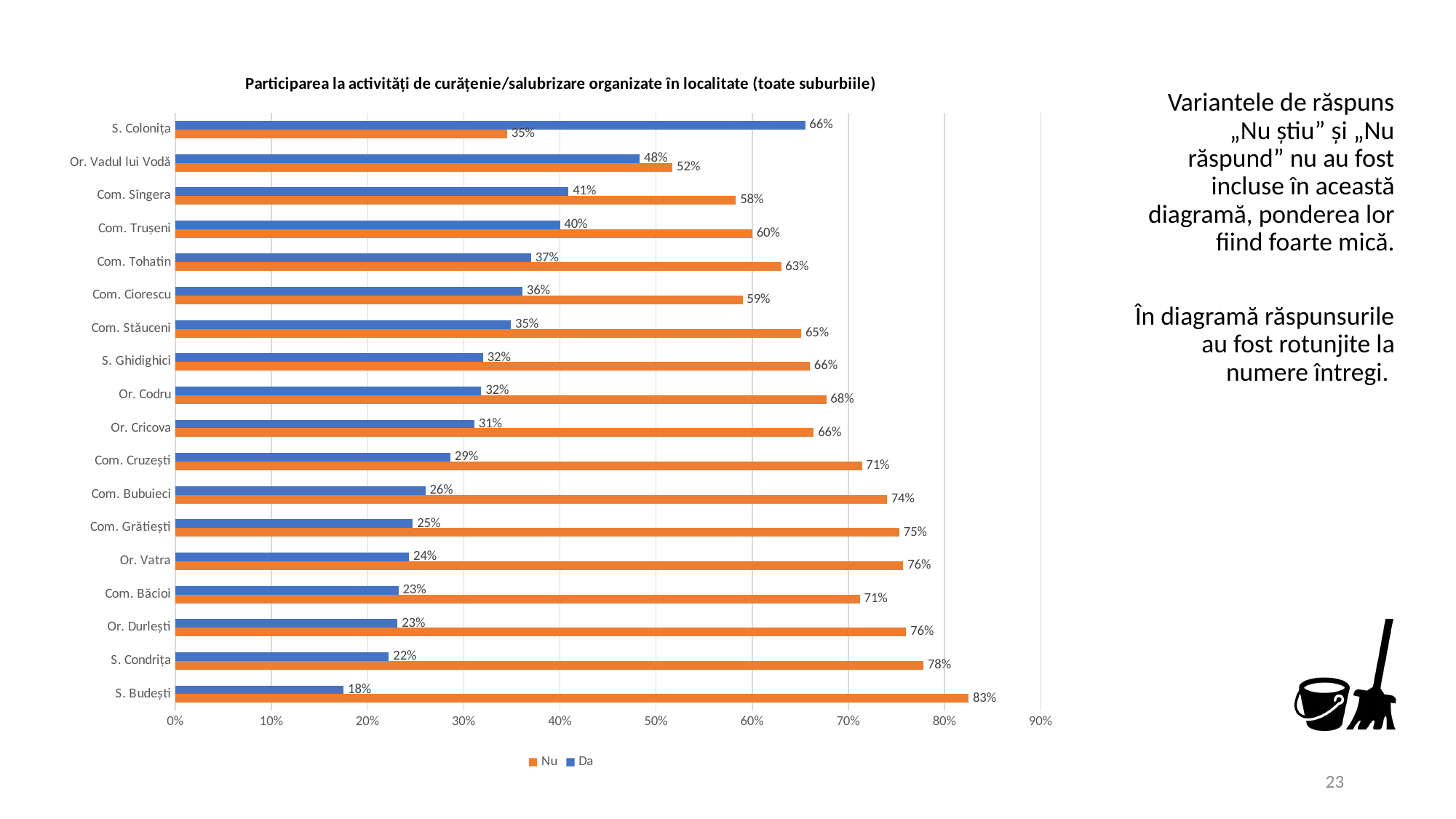
Which locality has the highest 'Nu' value? S. Budești What is the 'Da' value for S. Colonița? 66% Which locality has the lowest 'Da' value? S. Budești Which colour represents the 'Nu' series in the chart? Orange Which locality has the lowest 'Nu' value? S. Colonița How many localities are shown in the chart? 18 How many series does the legend list? 2 What is the 'Da' value for Or. Vadul lui Vodă? 48% What is the 'Nu' value for Com. Tohatin? 63% Which is larger for Or. Vadul lui Vodă: the 'Nu' value or the 'Da' value? Nu What type of chart is shown on the slide? Bar chart What is the difference between the 'Nu' and 'Da' values for S. Condrița? 56%